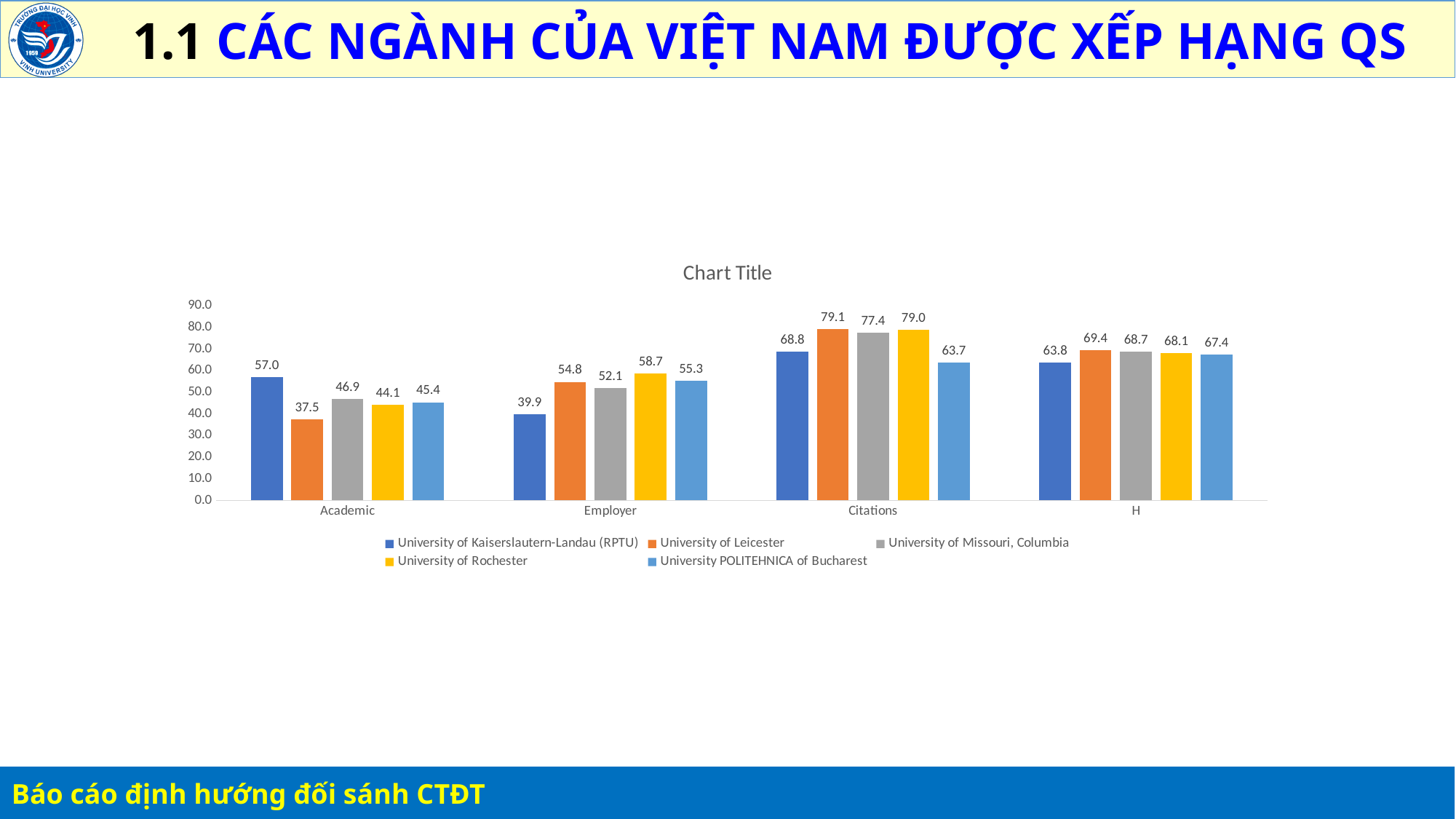
What is the difference between the Citations values of University of Leicester and University POLITEHNICA of Bucharest? 15.4 What kind of chart is shown on the slide? Bar chart Which university has the highest Employer value? University of Rochester What is the H value for University of Leicester? 69.4 How many series does the legend list? 5 Which university has the lowest Academic value? University of Leicester How many categories are shown on the x axis? 4 What is the Academic value for University of Kaiserslautern-Landau (RPTU)? 57.0 For the Employer category, which is larger: University of Kaiserslautern-Landau (RPTU) or University of Missouri, Columbia? University of Missouri, Columbia What is the Citations value for University POLITEHNICA of Bucharest? 63.7 Is the Academic value for University of Leicester greater or less than 40.0? less What is the Employer value for University of Rochester? 58.7